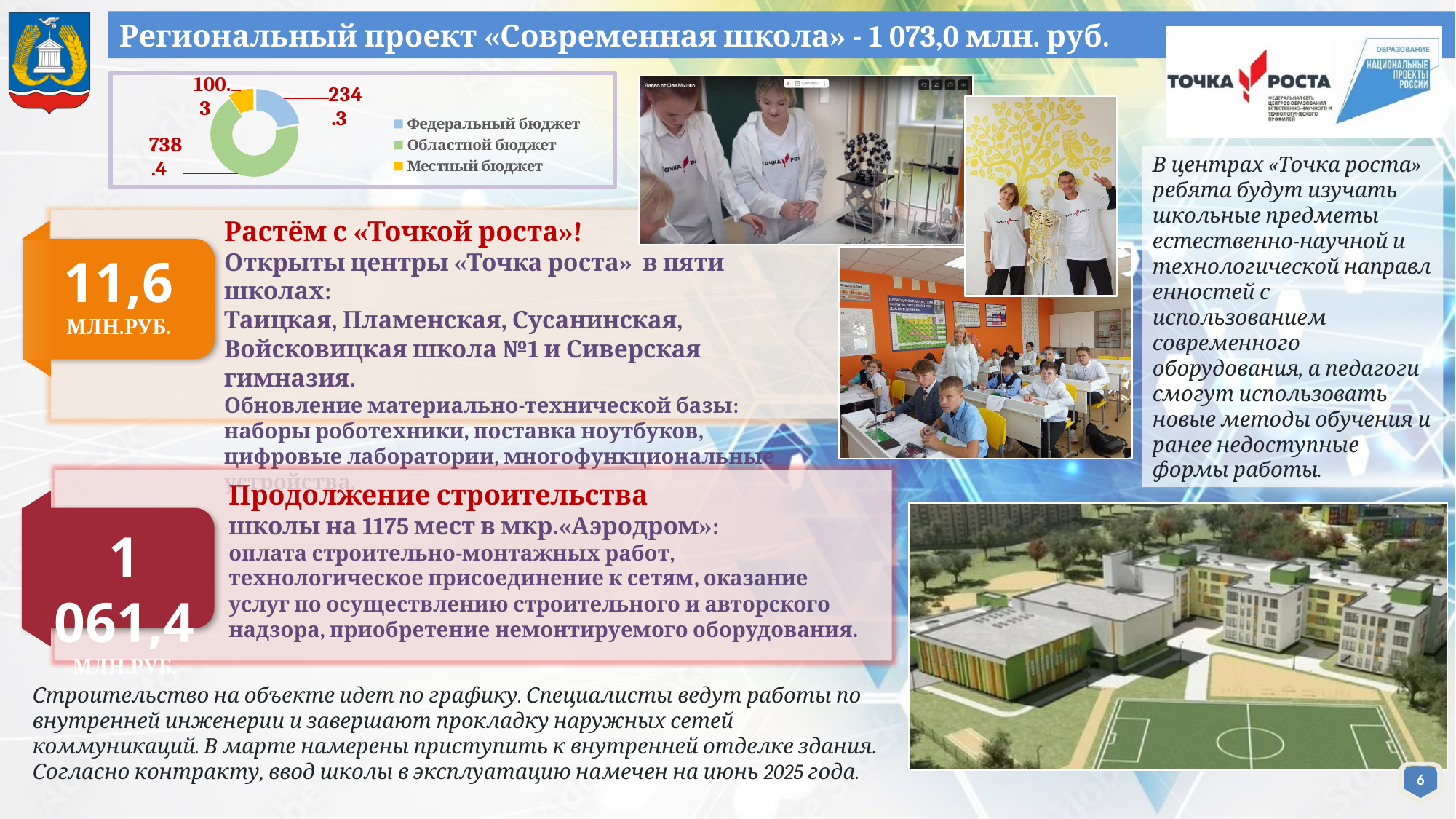
How many budget categories does the donut chart show? 3 What is the value for Областной бюджет in the donut chart? 738.4 What is the value for Федеральный бюджет in the donut chart? 234.3 What is the difference between Федеральный бюджет and Местный бюджет in the donut chart? 134.0 Which budget category has the smallest value in the donut chart? Местный бюджет What kind of chart is shown on the slide? Donut (pie) chart What colour represents Местный бюджет in the donut chart? Yellow What is the value for Местный бюджет in the donut chart? 100.3 How many entries does the legend of the donut chart list? 3 Which is larger in the donut chart: Федеральный бюджет or Местный бюджет? Федеральный бюджет Which budget category has the largest value in the donut chart? Областной бюджет What is the difference between Областной бюджет and Федеральный бюджет in the donut chart? 504.1